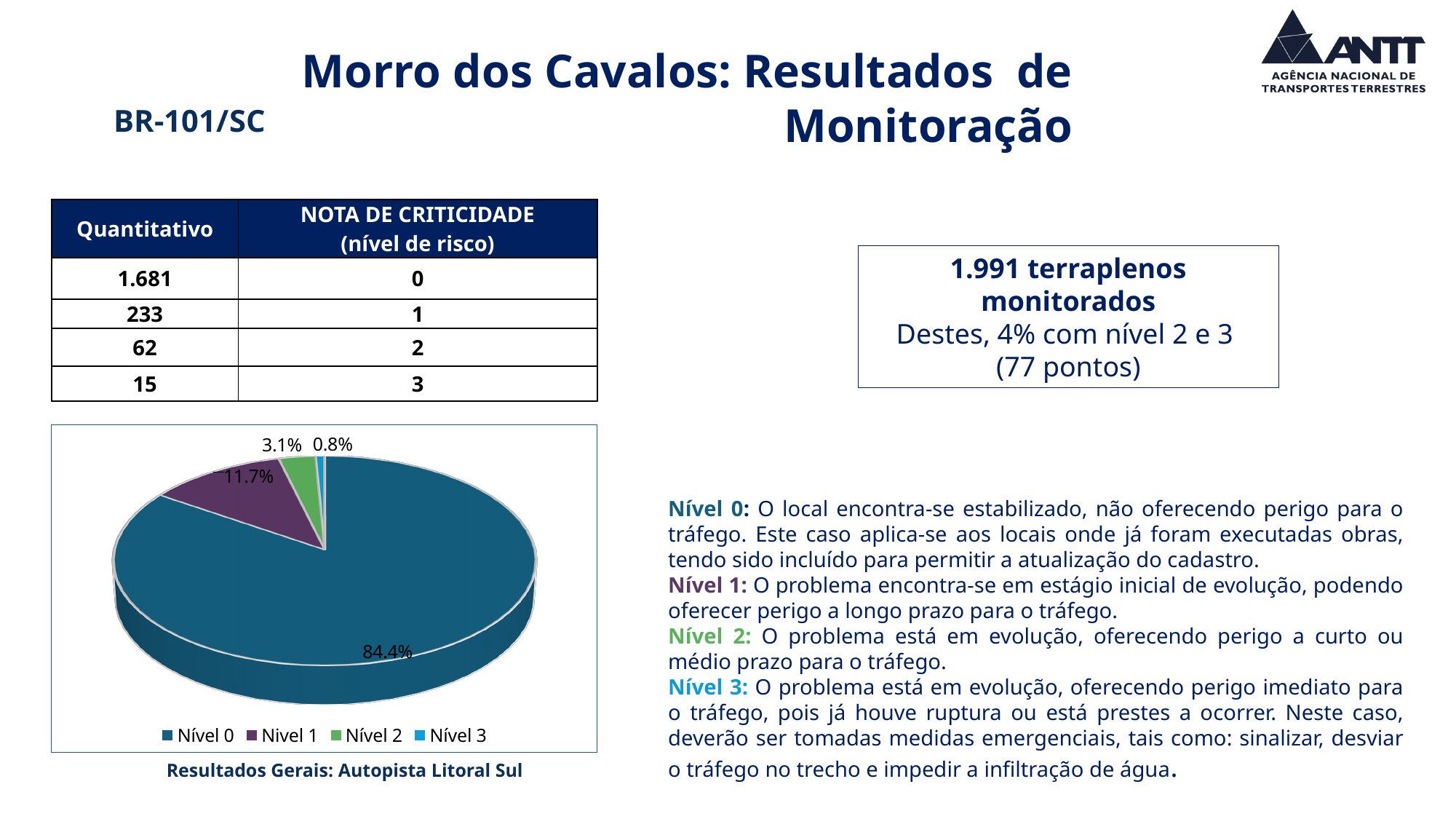
How many categories does the pie chart legend list? 4 What is the difference in percentage points between the Nível 0 and Nível 1 slices? 72.7 Which slice is larger, Nível 1 or Nível 2? Nível 1 What share of the pie does Nível 1 represent? 11.7% What caption appears below the pie chart? Resultados Gerais: Autopista Litoral Sul Which category has the smallest slice of the pie? Nível 3 What share of the pie does Nível 2 represent? 3.1% Which category has the largest slice of the pie? Nível 0 What share of the pie does Nível 0 represent? 84.4% What share of the pie does Nível 3 represent? 0.8% What kind of chart is shown on the slide? Pie chart What is the combined share of the Nível 2 and Nível 3 slices? 3.9%